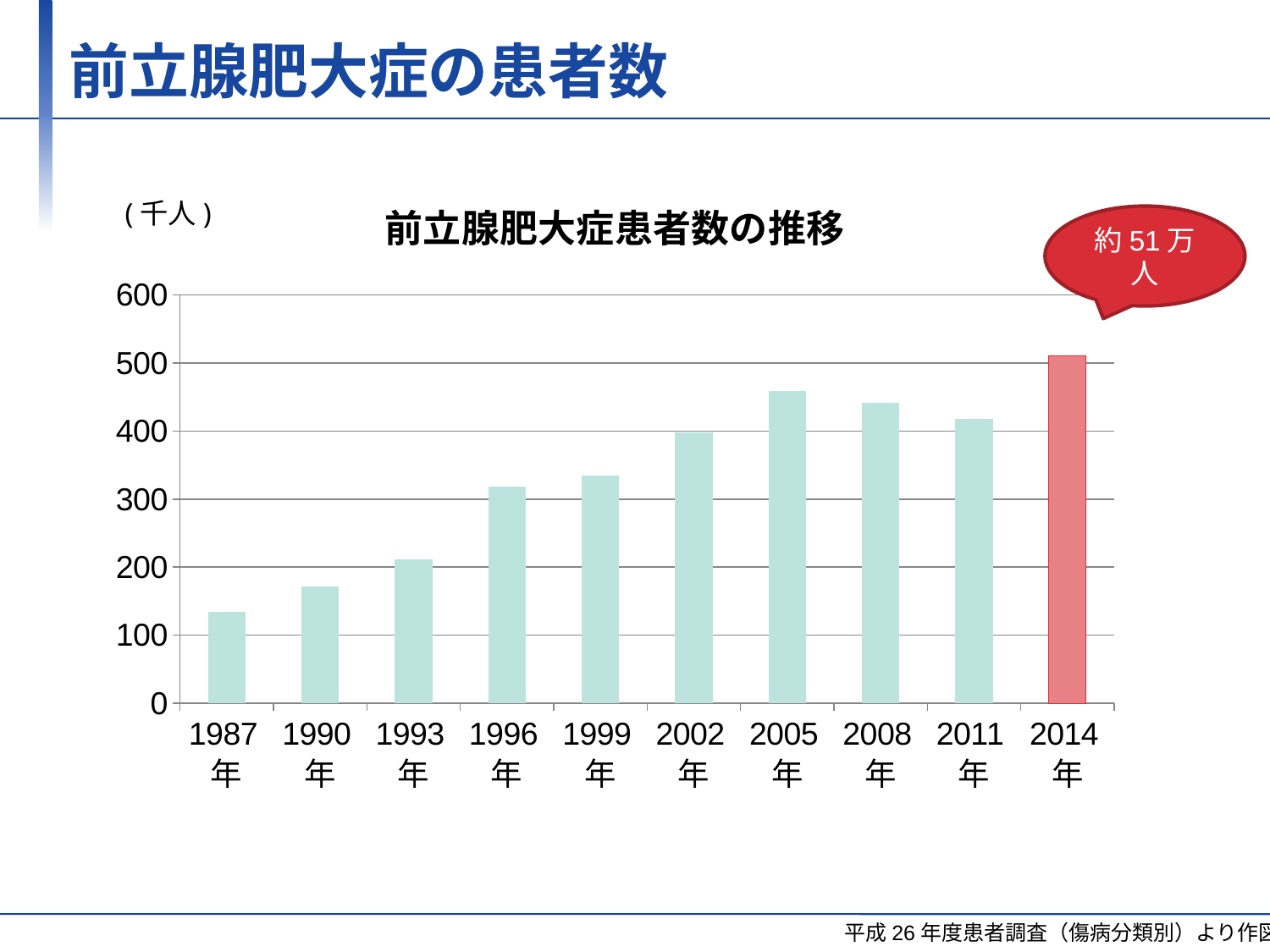
Is the value for 2014年 greater or less than 500? greater What is the title of the chart? 前立腺肥大症患者数の推移 Is the value for 1990年 greater or less than 200? less How many years (bars) are plotted in the chart? 10 Is the value for 1996年 greater or less than 300? greater What unit is shown for the vertical axis of the chart? 千人 Overall, do the values rise or fall from 1987年 to 2014年? rise Which year has a larger value, 2005年 or 2011年? 2005年 What kind of chart is shown on the slide? bar chart Which year has the highest number of patients? 2014年 Which year has the lowest number of patients? 1987年